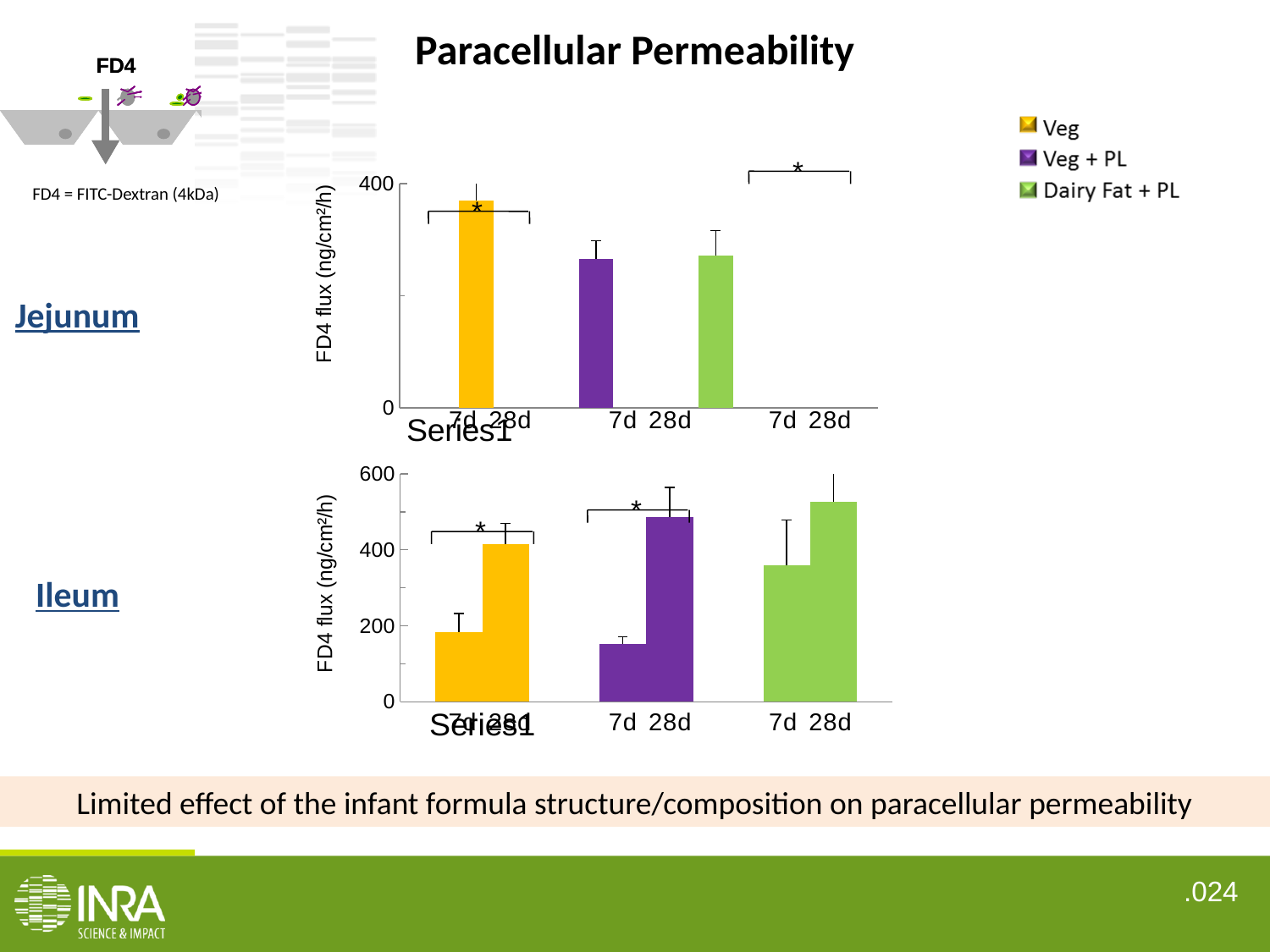
What is the y-axis label of the Ileum chart? FD4 flux (ng/cm²/h) In the Ileum chart, does the FD4 flux rise or fall from 7d to 28d for each group? rise In the Jejunum chart, is the value for Veg greater or less than 400? less In the Ileum chart, is the value for Veg + PL at 7d greater or less than 200? less In the Ileum chart, which is larger for Veg + PL: the 7d value or the 28d value? 28d In the Ileum chart, which bar is the lowest? Veg + PL at 7d In the Jejunum chart, which group has the highest FD4 flux? Veg In the Ileum chart, is the value for Dairy Fat + PL at 28d greater or less than 400? greater What kind of chart is the Jejunum chart? bar chart How many series does the legend list? 3